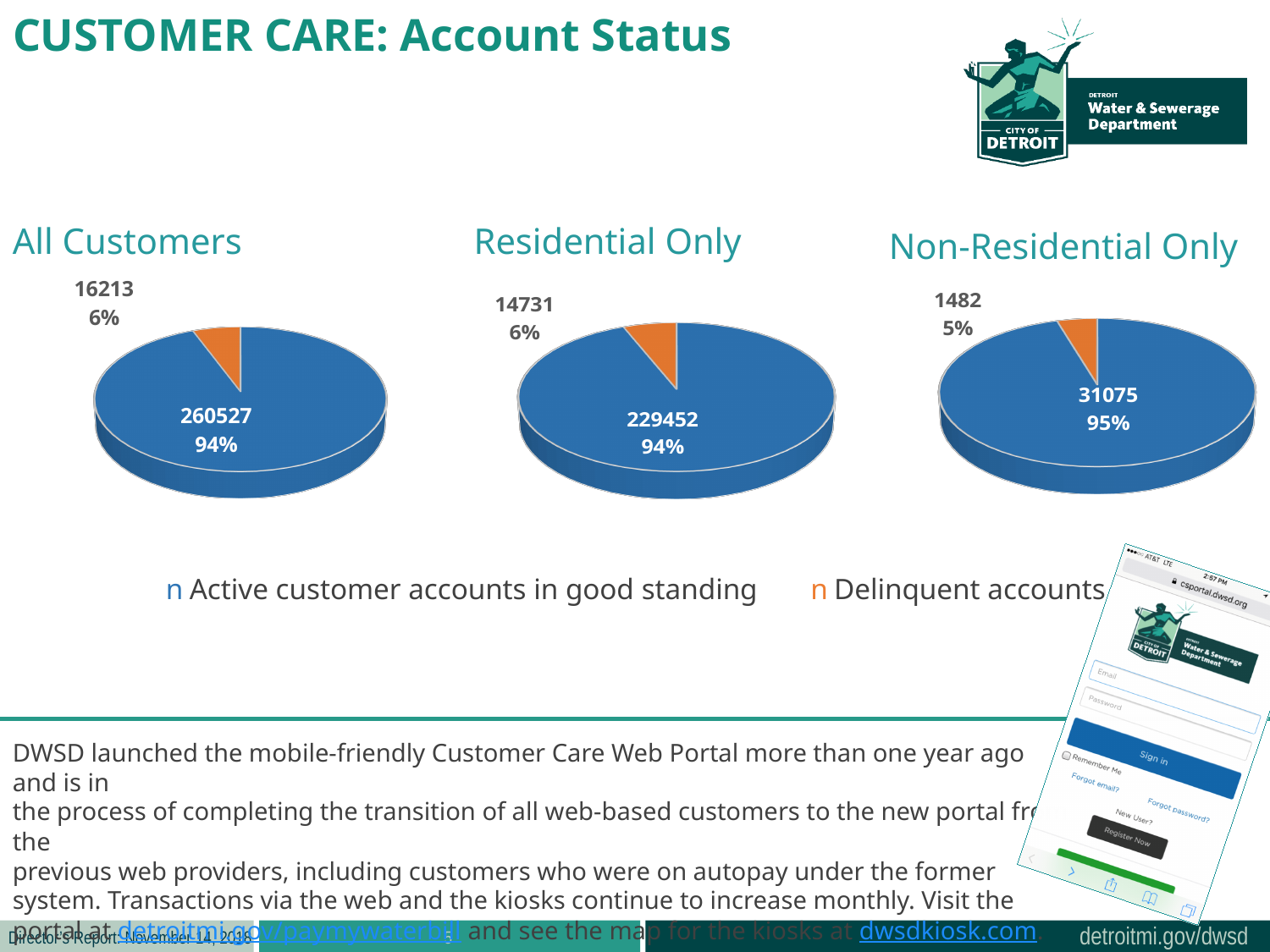
In the All Customers chart, how many active customer accounts in good standing are there? 260527 How many slices does the Non-Residential Only pie chart have? 2 In the Residential Only chart, how many delinquent accounts are there? 14731 In the All Customers chart, what share of accounts are delinquent? 6% How many series does the legend list for the charts? 2 Which colour represents delinquent accounts in the pie charts? Orange In the Residential Only chart, what share of accounts are active customer accounts in good standing? 94% In the All Customers chart, which slice is larger: active customer accounts in good standing or delinquent accounts? Active customer accounts in good standing In the Non-Residential Only chart, how many active customer accounts in good standing are there? 31075 In the Non-Residential Only chart, what share of accounts are delinquent? 5% In the Non-Residential Only chart, what is the difference between the number of active accounts in good standing and the number of delinquent accounts? 29593 What kind of chart is used for the Residential Only data? Pie chart